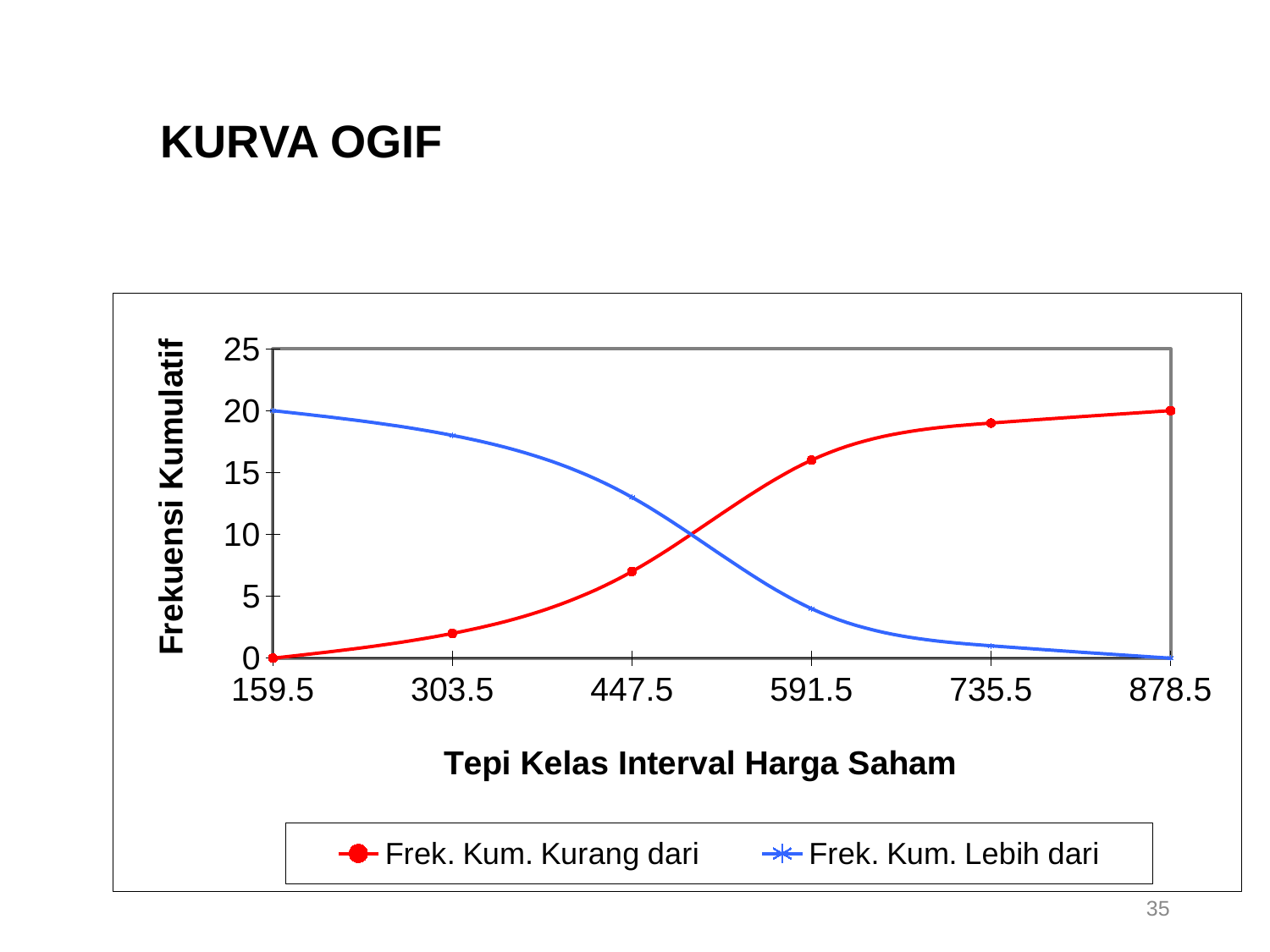
Is the value of Frek. Kum. Lebih dari at 591.5 greater or less than 5? less What is the label of the x axis? Tepi Kelas Interval Harga Saham Is the value of Frek. Kum. Kurang dari at 591.5 greater or less than 15? greater At 447.5, which series has the larger value, Frek. Kum. Kurang dari or Frek. Kum. Lebih dari? Frek. Kum. Lebih dari How many series does the legend list? 2 What is the value of Frek. Kum. Kurang dari at 159.5? 0 How many x-axis categories are plotted on the chart? 6 What is the value of Frek. Kum. Lebih dari at 159.5? 20 Does Frek. Kum. Lebih dari rise or fall as the x-axis values increase? fall What is the value of Frek. Kum. Kurang dari at 878.5? 20 Does Frek. Kum. Kurang dari rise or fall as the x-axis values increase? rise What kind of chart is shown on the slide? line chart